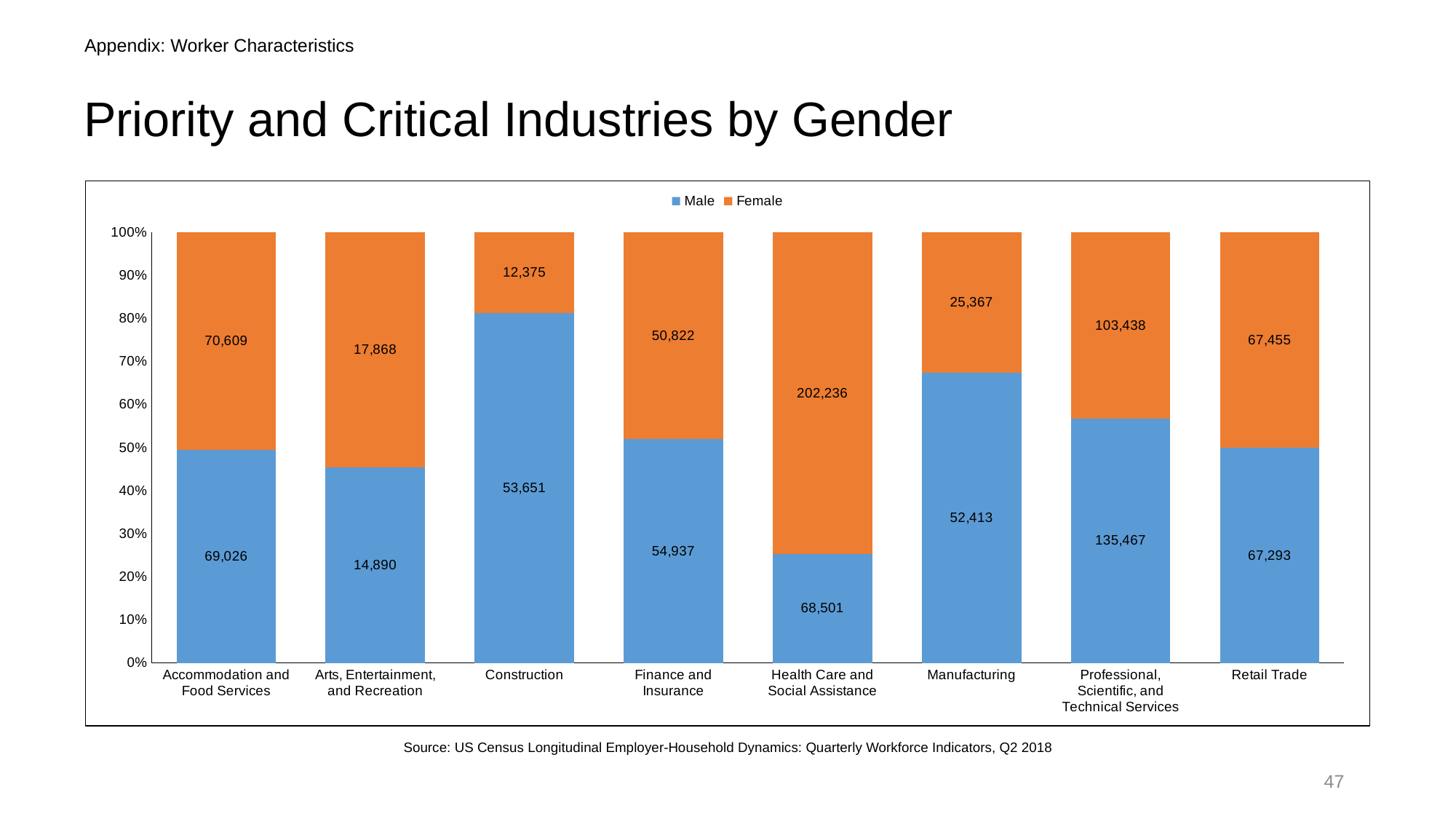
Which industry has the highest Female value? Health Care and Social Assistance How many industries are shown on the x axis? 8 What is the Female value for Construction? 12,375 Which is larger for Manufacturing, the Male value or the Female value? Male Is the Male share of the Health Care and Social Assistance bar greater or less than 30%? less What is the total of the Male and Female values for Health Care and Social Assistance? 270,737 What is the Female value for Professional, Scientific, and Technical Services? 103,438 How many series does the legend list? 2 Which industry has the lowest Male value? Arts, Entertainment, and Recreation What kind of chart is shown on the slide? Stacked bar chart What is the difference between the Male and Female values for Construction? 41,276 What is the Male value for Health Care and Social Assistance? 68,501